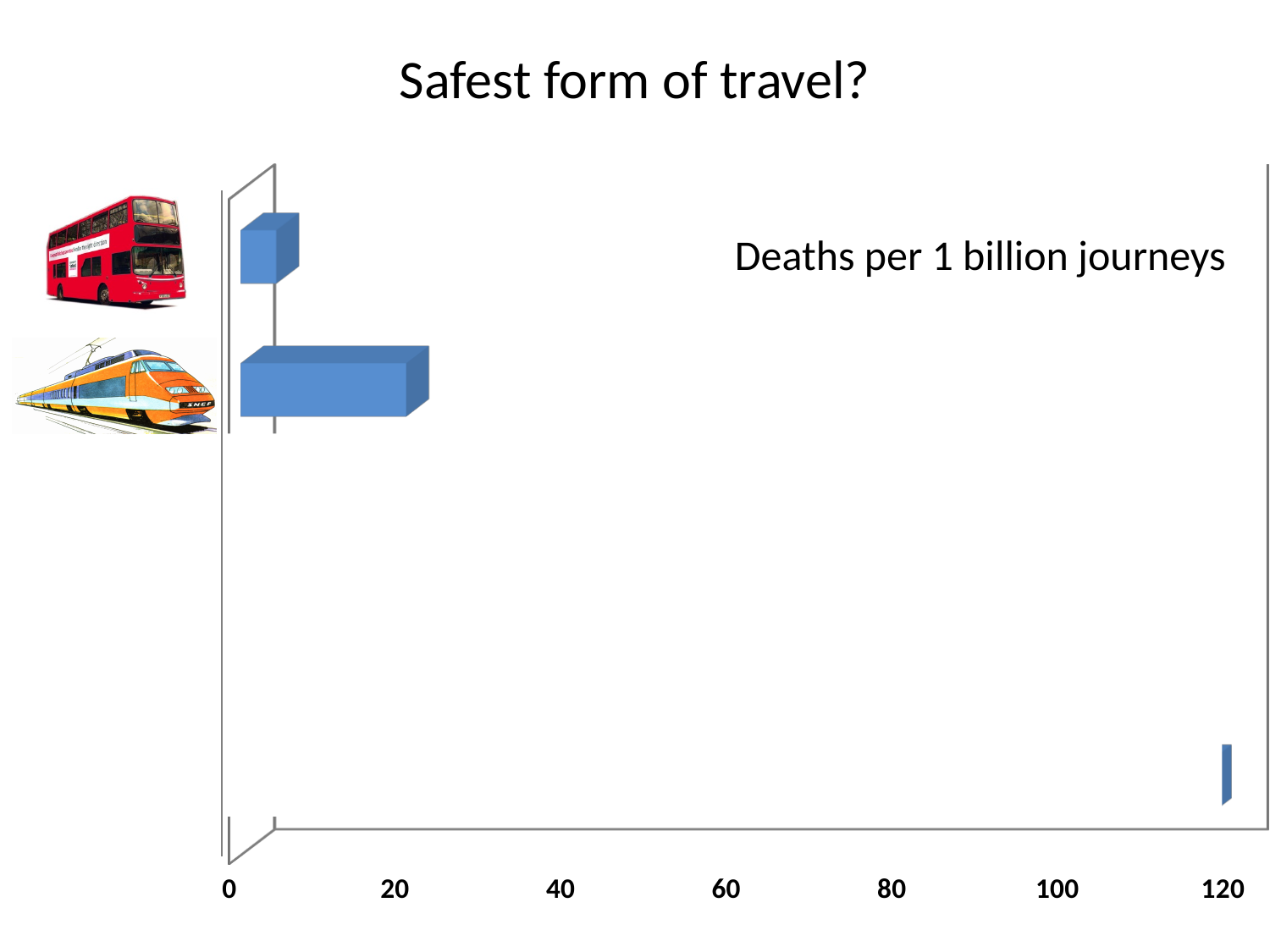
What kind of chart is shown on the slide? bar chart Is the value for the bar next to the train picture greater or less than 40? less What is the highest value shown on the horizontal axis? 120 Is the value for the bar next to the bus picture greater or less than 20? less What is the title of the slide above the chart? Safest form of travel? What does the text label inside the chart say the values represent? Deaths per 1 billion journeys Of the bus and the train, which has the higher number of deaths per 1 billion journeys? train Of the bus and the train, which has the lower number of deaths per 1 billion journeys? bus Which bar is longer, the one next to the bus picture or the one next to the train picture? the train